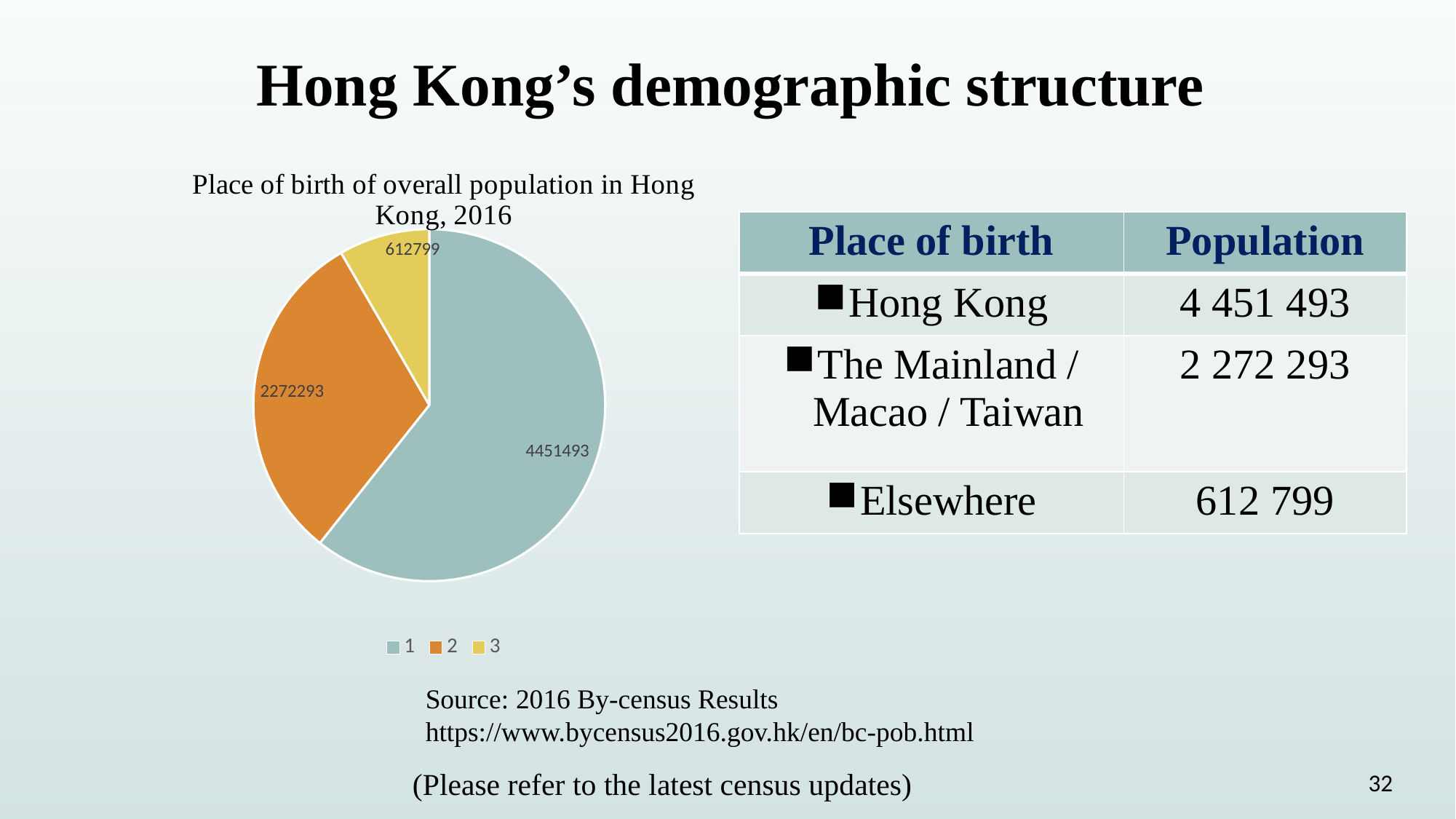
How many entries does the pie chart's legend list? 3 What value is labelled on the yellow slice (legend entry 3) of the pie chart? 612799 How many slices does the pie chart have? 3 Which legend entry corresponds to the smallest slice of the pie chart? 3 Which legend entry corresponds to the largest slice of the pie chart? 1 What is the difference between the values of the slice labelled 4451493 and the slice labelled 2272293? 2179200 What value is labelled on the largest slice of the pie chart (legend entry 1)? 4451493 What kind of chart is shown on the slide? Pie chart What colour is the largest slice of the pie chart? Teal (grey-green) What value is labelled on the orange slice (legend entry 2) of the pie chart? 2272293 What is the title of the pie chart? Place of birth of overall population in Hong Kong, 2016 Which slice is larger in the pie chart, the one labelled 2272293 or the one labelled 612799? 2272293